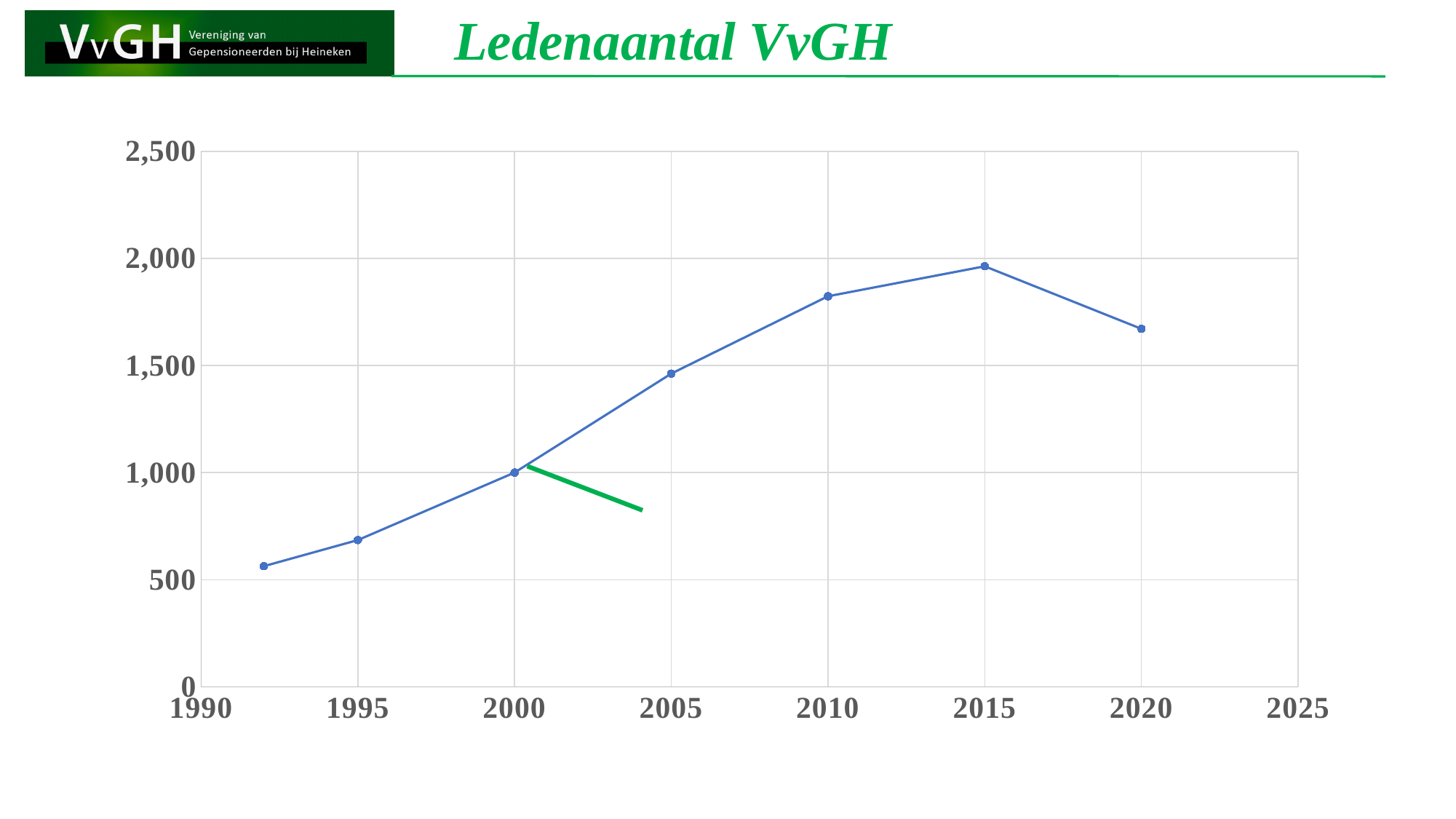
How many data points are plotted on the line? 7 Does the line rise or fall between 2015 and 2020? fall What is the title of the chart? Ledenaantal VvGH In which year does the line reach its highest value? 2015 Is the value for 2020 greater or less than 2,000? less What is the value plotted for the year 2000? 1,000 Is the value for 1995 greater or less than 500? greater Is the value for 2005 greater or less than 1,500? less What colour is the short extra line segment drawn from the 2000 data point? green What kind of chart is shown on the slide? line chart Which year has the larger value, 2010 or 2020? 2010